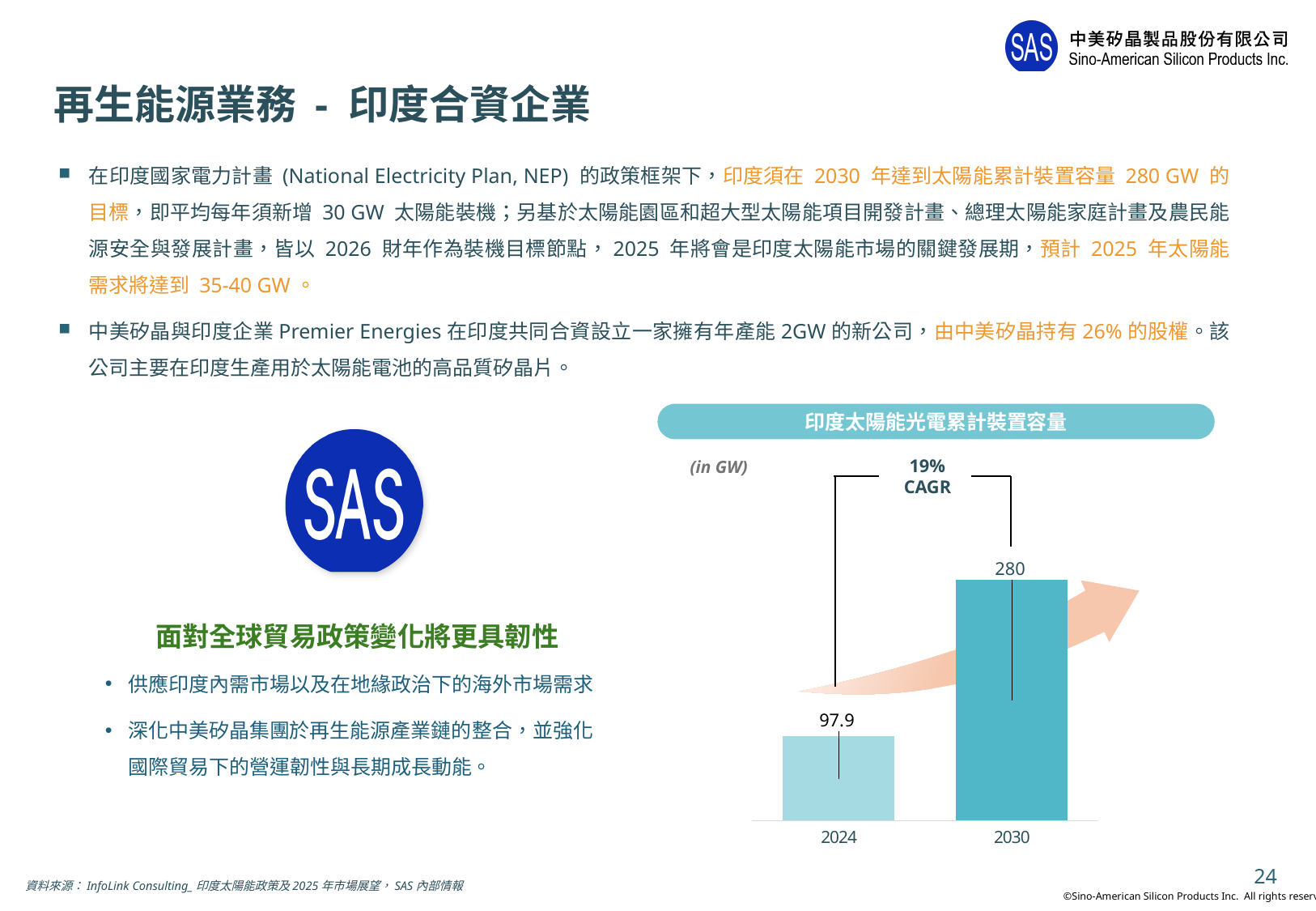
What is the value for 2030 in the 印度太陽能光電累計裝置容量 chart? 280 What is the difference between the 2030 and 2024 values in the chart? 182.1 What kind of chart is shown on the slide? bar chart Is the value for 2030 larger or smaller than the value for 2024? larger What is the value for 2024 in the 印度太陽能光電累計裝置容量 chart? 97.9 How many bars are shown in the chart? 2 Which year has the lower value in the chart? 2024 What CAGR is annotated on the chart? 19% What unit is indicated for the chart values? GW Which year has the higher value in the chart? 2030 Do the values rise or fall from 2024 to 2030? rise